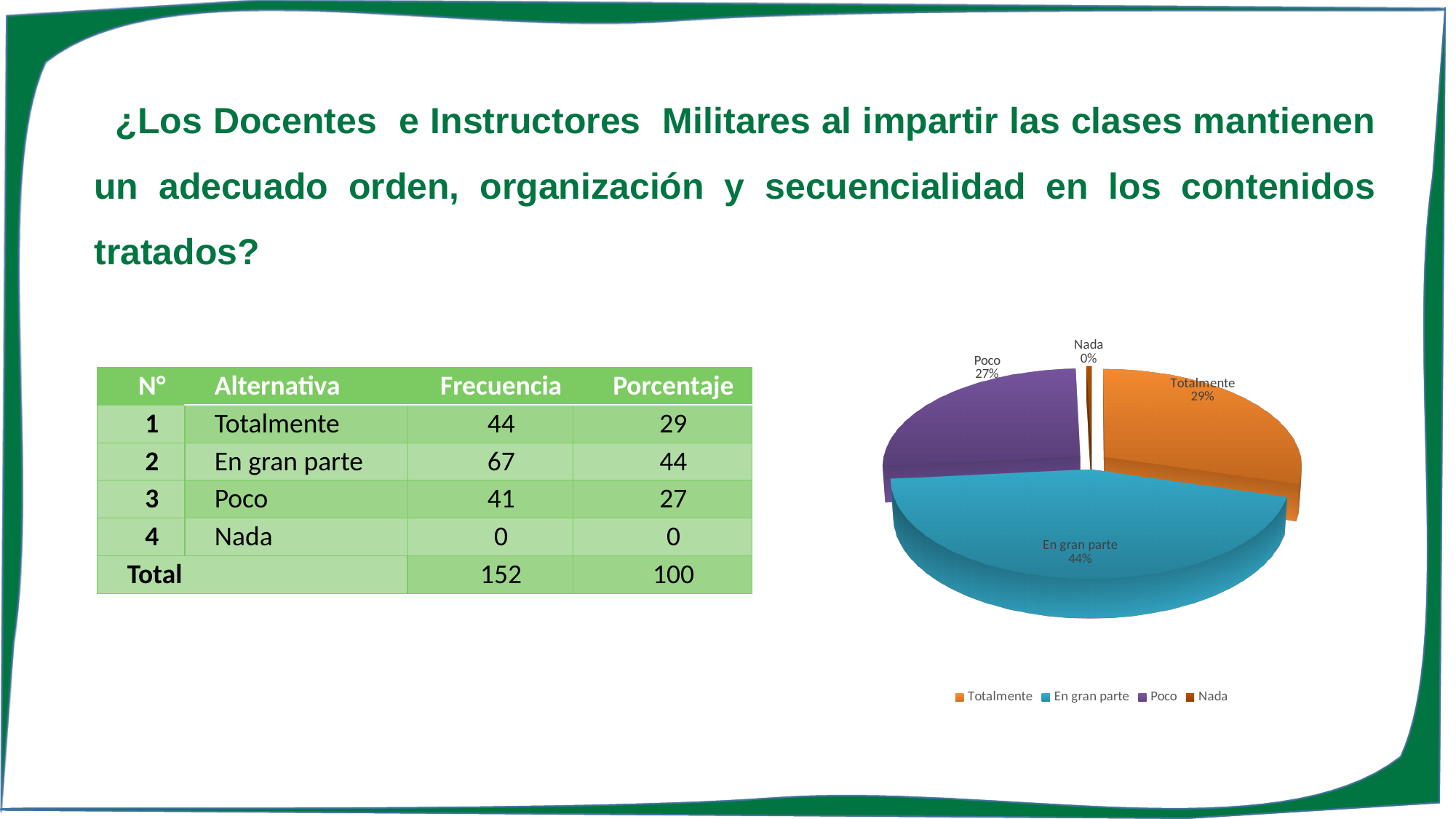
Which slice is larger in the pie chart, Totalmente or Poco? Totalmente How many categories does the pie chart legend list? 4 Which category has the largest slice in the pie chart? En gran parte Which category is shown in purple in the pie chart? Poco What percentage does the pie chart show for Totalmente? 29% What kind of chart is shown on the slide? Pie chart What percentage does the pie chart show for En gran parte? 44% Which category has the smallest slice in the pie chart? Nada What percentage does the pie chart show for Poco? 27% What is the difference in percentage points between En gran parte and Totalmente in the pie chart? 15 What colour is the En gran parte slice in the pie chart? Blue What percentage does the pie chart show for Nada? 0%